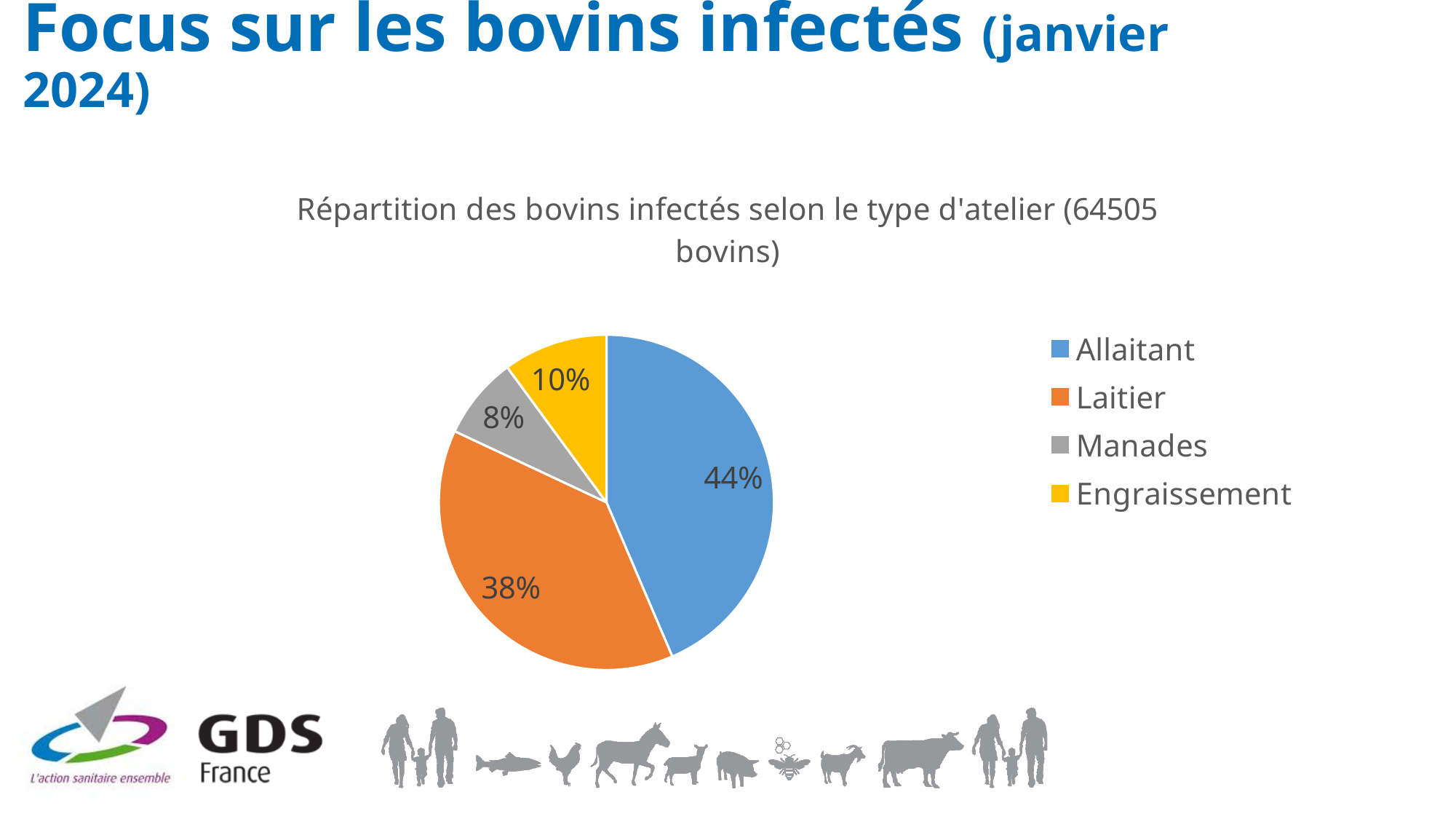
Which has a larger share, Engraissement or Manades? Engraissement What is the difference in percentage points between the Allaitant and Laitier shares? 6 What colour represents the Laitier category in the pie chart? Orange What share of infected cattle is in the Manades category? 8% What is the title of the chart? Répartition des bovins infectés selon le type d'atelier (64505 bovins) What share of infected cattle is in the Engraissement category? 10% Which category has the smallest share of infected cattle? Manades Which category has the largest share of infected cattle? Allaitant What share of infected cattle is in the Allaitant category? 44% How many categories does the pie chart show? 4 What kind of chart is shown on the slide? Pie chart